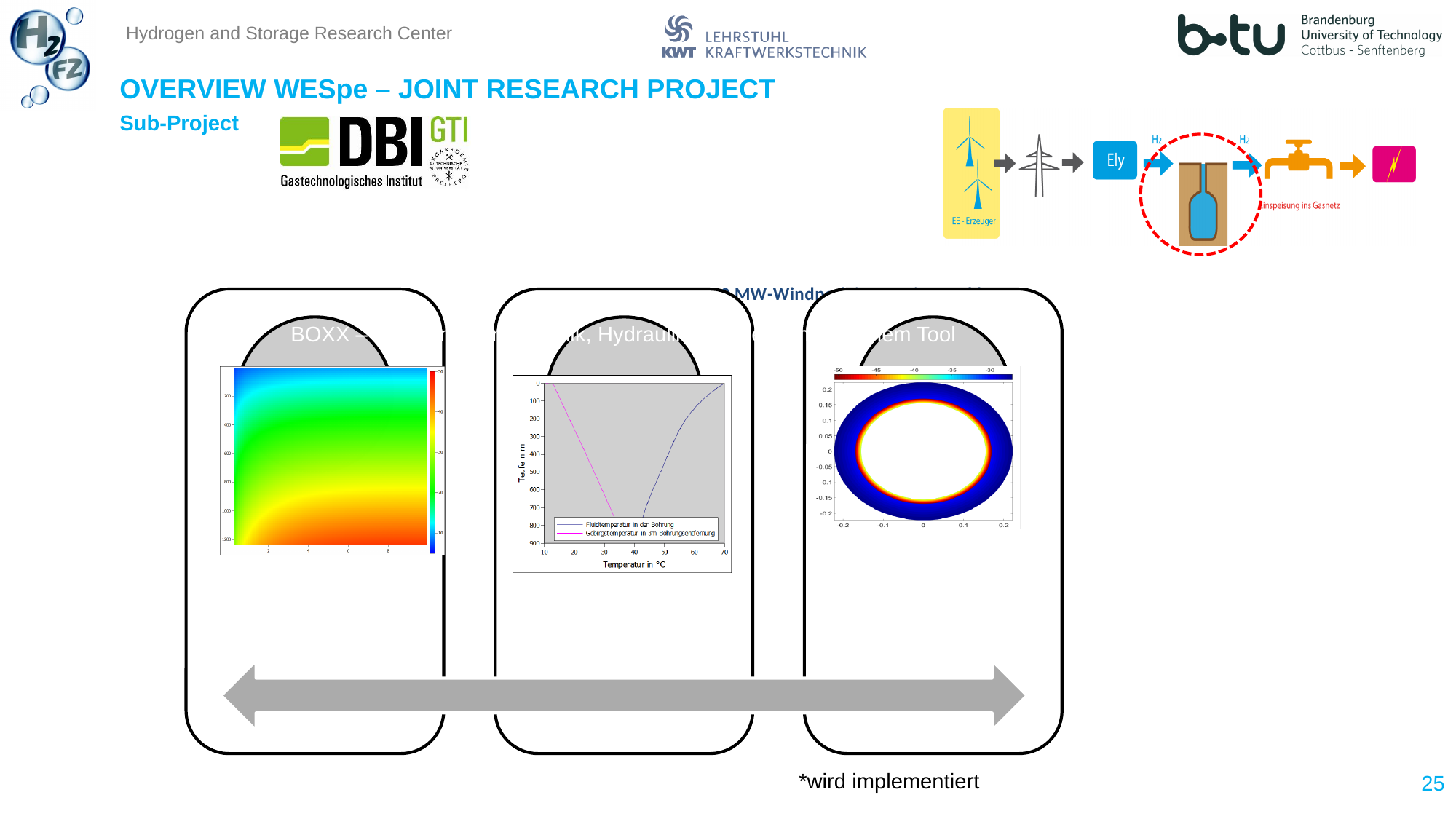
What is the maximum value shown on the colour bar of the left chart? 50 In the middle chart, at a depth of 0 m, which series has the higher temperature, 'Fluidtemperatur in der Bohrung' or 'Gebirgstemperatur in 3m Bohrungsentfernung'? Fluidtemperatur in der Bohrung What kind of chart is the middle chart (with the x axis 'Temperatur in °C')? line chart In the middle chart, does the 'Fluidtemperatur in der Bohrung' temperature rise or fall as depth (Teufe) increases from 0 m to 800 m? fall What is the y-axis label of the middle chart? Teufe in m In the middle chart, does the 'Gebirgstemperatur in 3m Bohrungsentfernung' temperature rise or fall as depth (Teufe) increases from 0 m to 800 m? rise In the middle chart, at a depth of 0 m, is the 'Fluidtemperatur in der Bohrung' greater or less than 60 °C? greater How many series does the legend of the middle chart list? 2 In the middle chart, at a depth of 0 m, is the 'Gebirgstemperatur in 3m Bohrungsentfernung' greater or less than 20 °C? less In the middle chart, which series is drawn in magenta? Gebirgstemperatur in 3m Bohrungsentfernung What is the minimum value shown on the colour bar of the right chart? -50 What is the x-axis label of the middle chart? Temperatur in °C